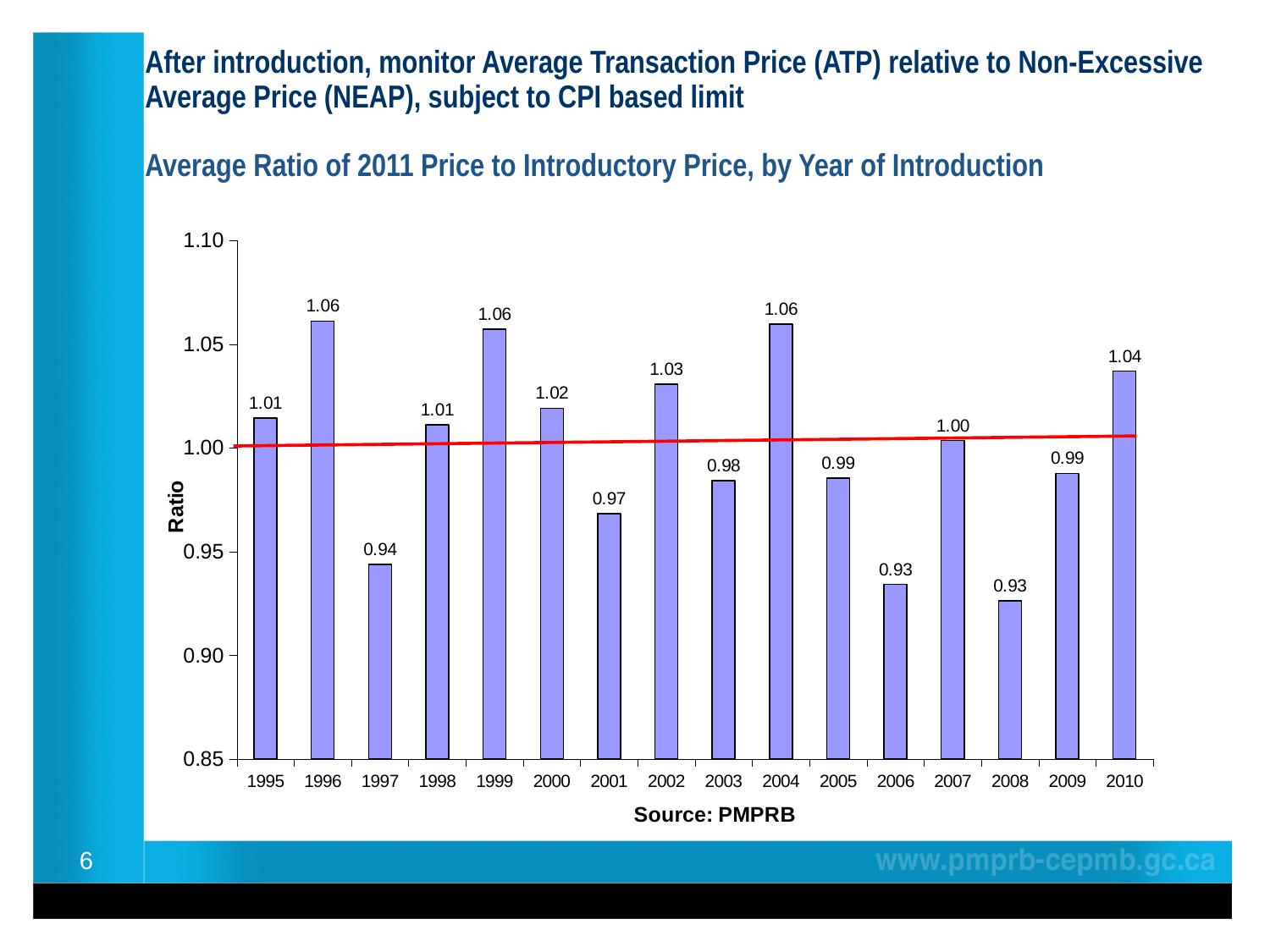
Which year has the larger ratio, 2000 or 2001? 2000 How many years of introduction are shown on the x axis? 16 Which year has the larger ratio, 2002 or 2003? 2002 What is the ratio value for 2007? 1.00 What is the difference between the ratio for 2002 and the ratio for 2003? 0.05 What kind of chart is shown on the slide? bar chart What is the ratio value for 1997? 0.94 What is the ratio value for 2002? 1.03 What is the ratio value for 2010? 1.04 What is the difference between the ratio for 2010 and the ratio for 1997? 0.10 Is the value for 1997 greater or less than 0.95? less What is the label on the vertical axis of the chart? Ratio